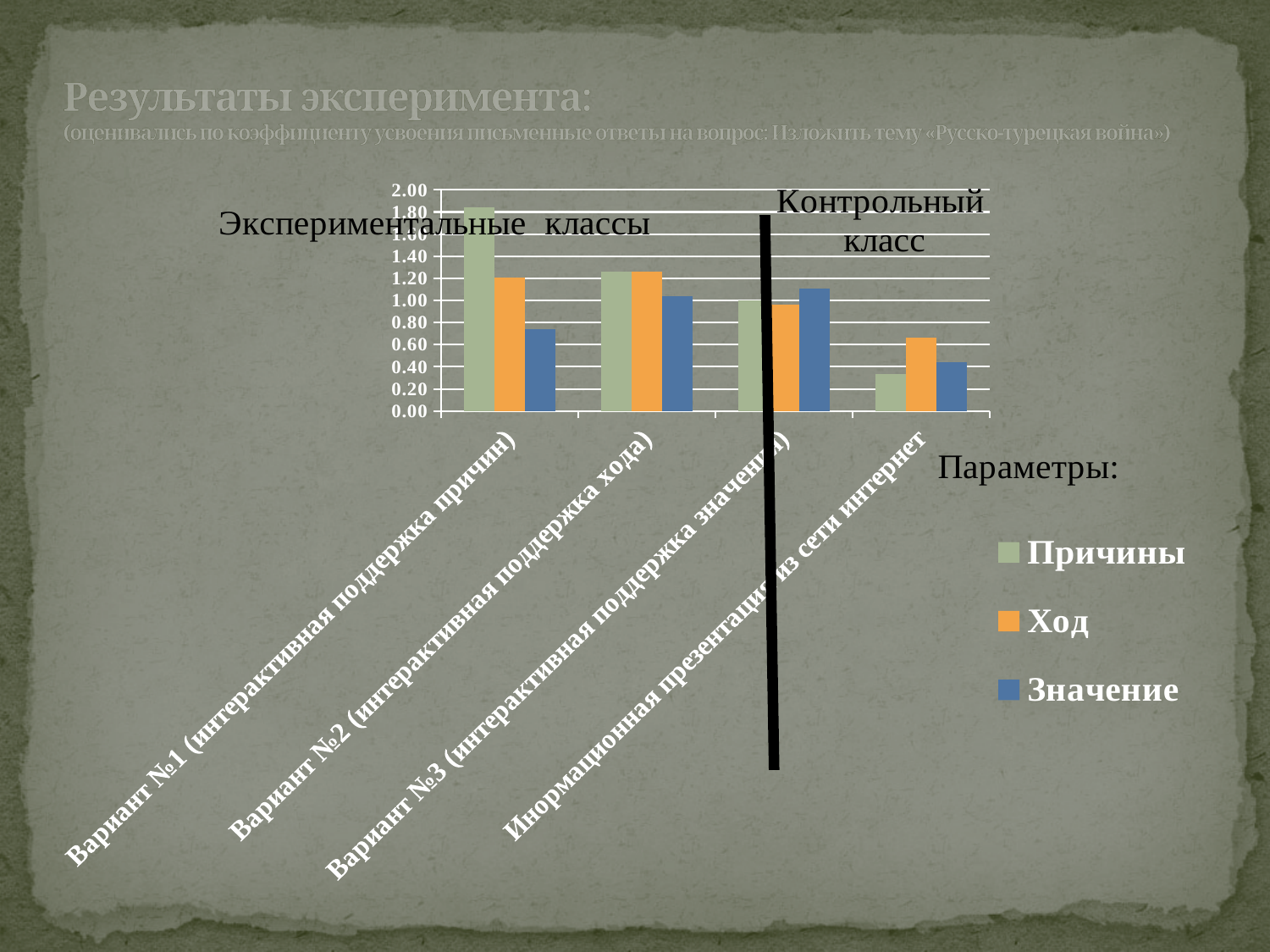
Is the Причины value for Вариант №1 (интерактивная поддержка причин) greater or less than 1.60? greater What kind of chart is shown on the slide? bar chart How many categories are shown on the x axis? 4 Is the Значение value for Вариант №1 (интерактивная поддержка причин) greater or less than 0.80? less Is the Значение value for Вариант №2 (интерактивная поддержка хода) greater or less than 0.80? greater Which category has the lowest value for the Причины series? Инормационная презентация из сети интернет For Вариант №1 (интерактивная поддержка причин), which is larger: the Причины value or the Ход value? Причины Do the Причины values rise or fall from left to right along the x axis? fall How many series does the legend list? 3 Which category has the highest value for the Причины series? Вариант №1 (интерактивная поддержка причин) What are the three legend entries of the chart? Причины, Ход, Значение